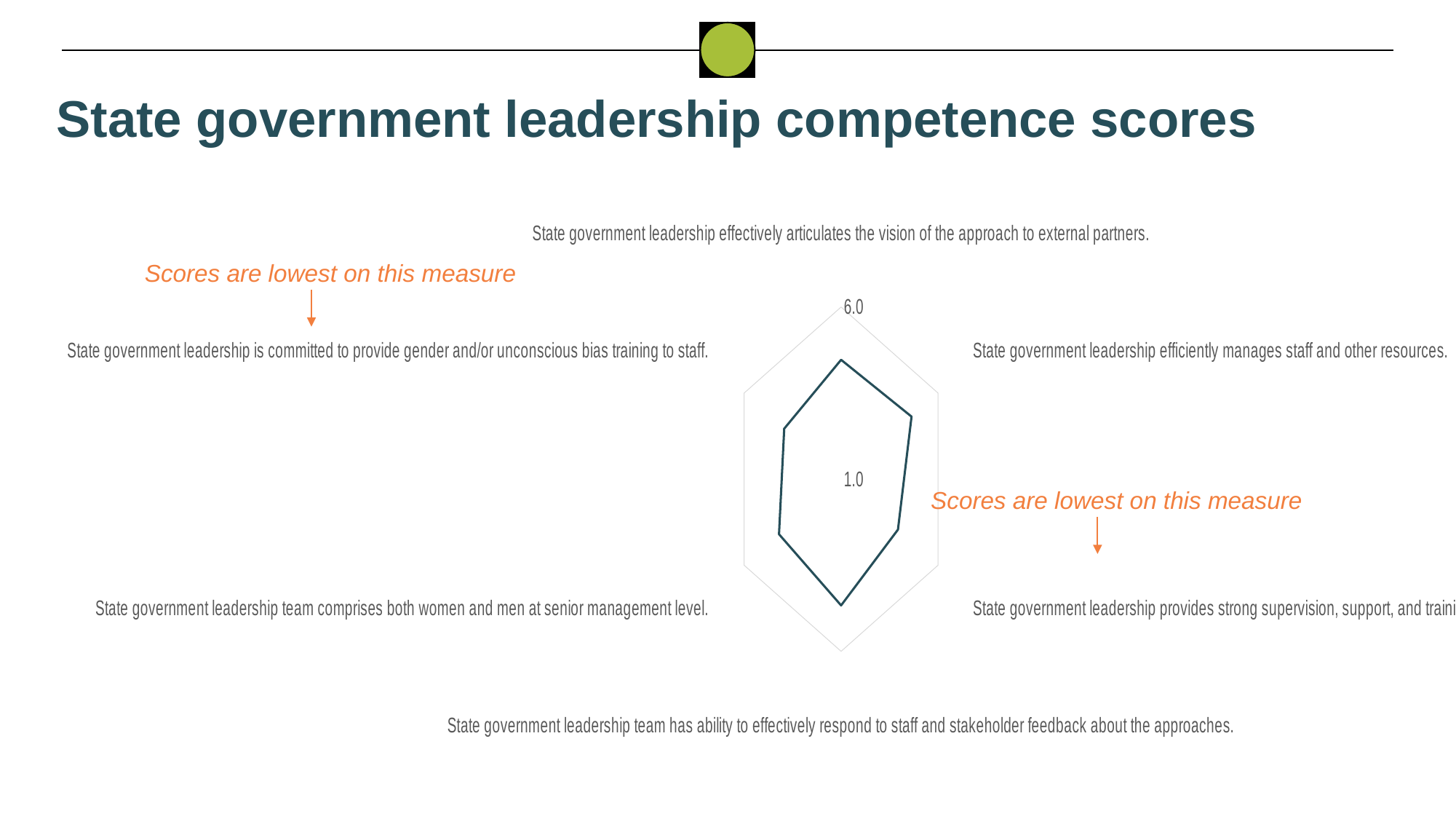
What is the value labelled at the centre of the radar chart? 1.0 What kind of chart is shown on the slide? Radar chart Which score is larger: 'State government leadership effectively articulates the vision of the approach to external partners' or 'State government leadership provides strong supervision, support, and training'? State government leadership effectively articulates the vision of the approach to external partners Is the score for 'State government leadership effectively articulates the vision of the approach to external partners' greater or less than 6.0? less What is the highest value labelled on the radar chart's axis? 6.0 What does the orange annotation text on the slide say about the measures it points to? Scores are lowest on this measure Which score is larger: 'State government leadership team has ability to effectively respond to staff and stakeholder feedback about the approaches' or 'State government leadership provides strong supervision, support, and training'? State government leadership team has ability to effectively respond to staff and stakeholder feedback about the approaches How many measures (axes) does the radar chart have? 6 What is the title of the slide containing the chart? State government leadership competence scores Is the score for 'State government leadership provides strong supervision, support, and training' greater or less than 6.0? less